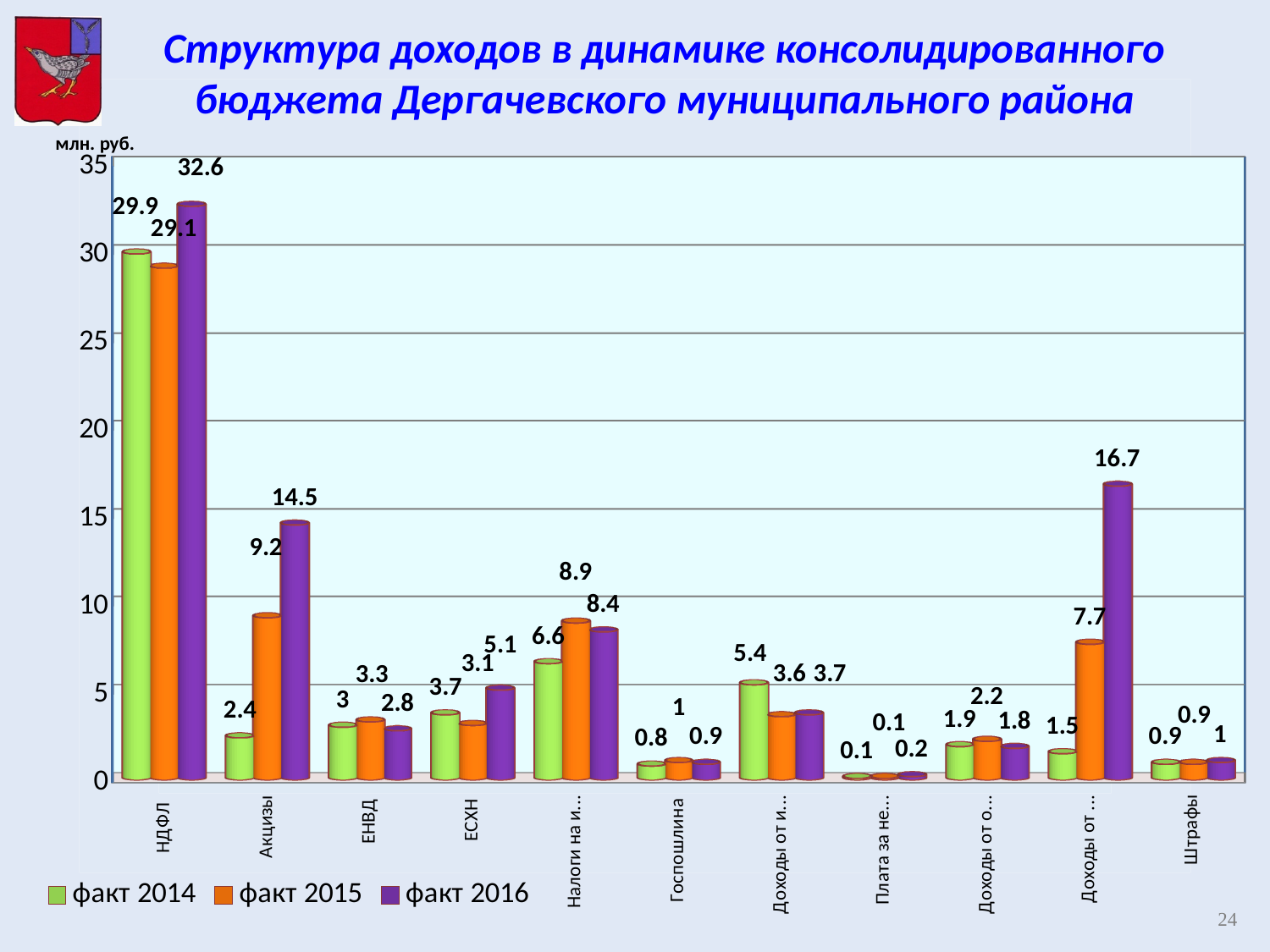
For ЕНВД, which series has the larger value: факт 2015 or факт 2016? факт 2015 How many series does the legend list? 3 What is the difference between the факт 2016 and факт 2015 values for НДФЛ? 3.5 Which category has the highest value in the факт 2016 series? НДФЛ What kind of chart is shown on the slide? bar chart What is the value for Акцизы in the факт 2015 series? 9.2 What is the value for НДФЛ in the факт 2016 series? 32.6 How many categories are shown on the x axis? 11 What is the value for ЕСХН in the факт 2014 series? 3.7 Do the values for Акцизы rise or fall from факт 2014 to факт 2016? rise What is the value for Госпошлина in the факт 2015 series? 1 What is the difference between the факт 2016 and факт 2014 values for Акцизы? 12.1